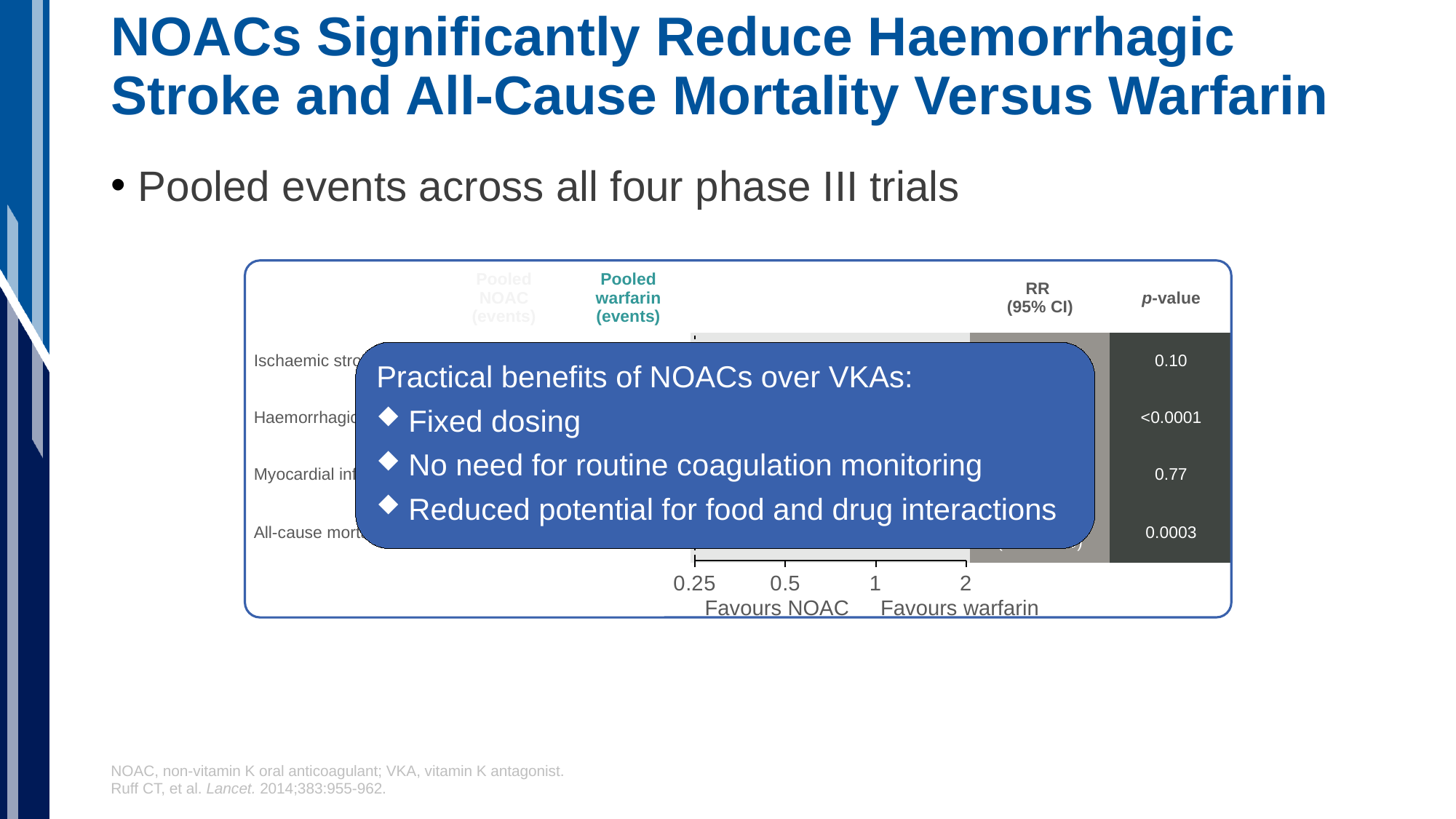
What is the p-value shown for all-cause mortality? 0.0003 What is the p-value shown for haemorrhagic stroke? <0.0001 What are the tick values shown on the x axis of the forest plot? 0.25, 0.5, 1, 2 Which outcome has the smallest p-value in the forest plot? Haemorrhagic stroke What is the p-value shown for ischaemic stroke? 0.10 Which side of the forest plot's x axis is labelled 'Favours NOAC'? Left How many outcome rows are listed in the forest plot? 4 What kind of chart is shown on the slide? Forest plot What is the p-value shown for myocardial infarction? 0.77 Which outcome has the largest p-value in the forest plot? Myocardial infarction Which has the larger p-value, ischaemic stroke or all-cause mortality? Ischaemic stroke